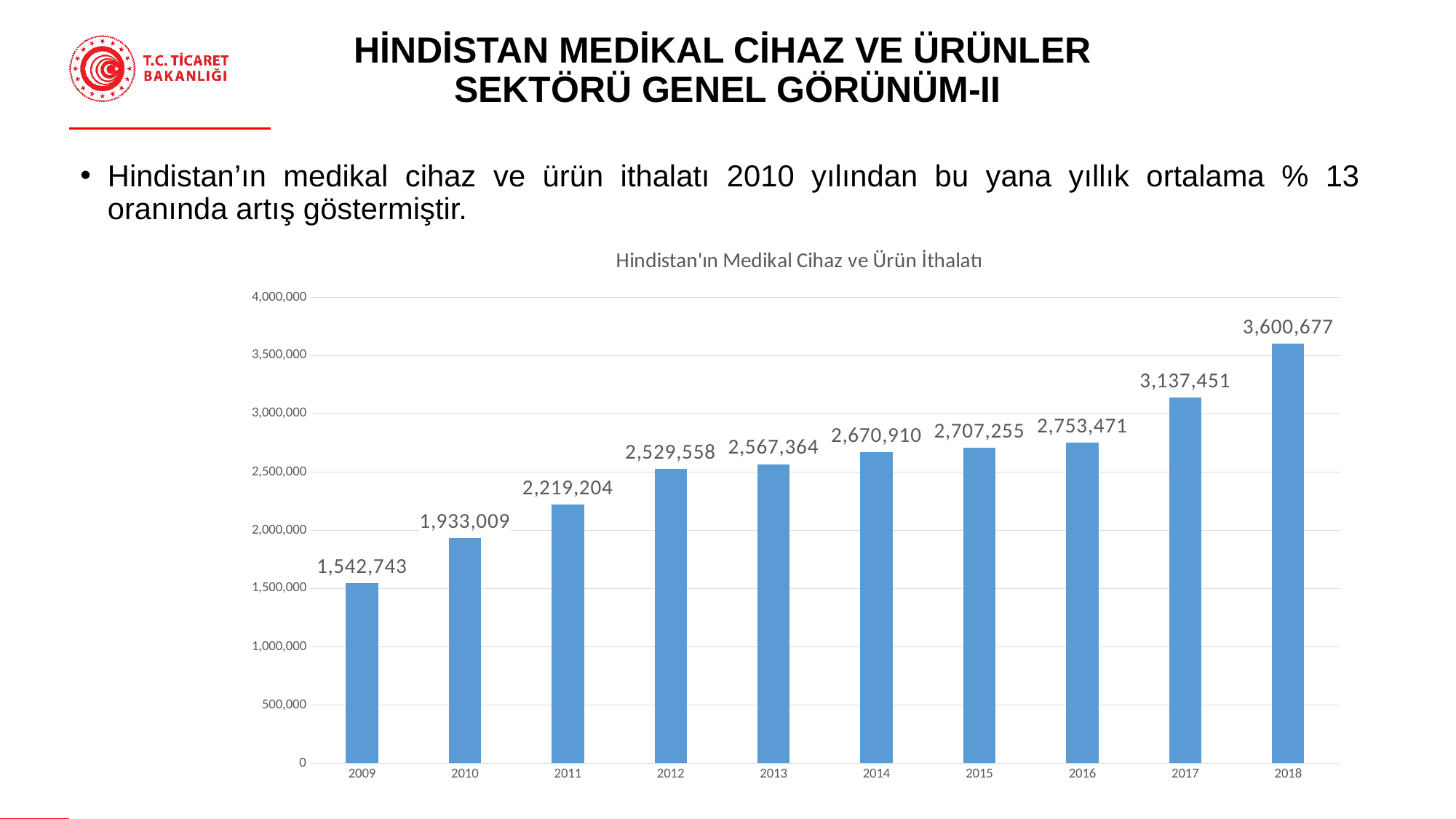
What is the value for 2018 in the chart? 3,600,677 Which year has the highest value in the chart? 2018 What is the value for 2014 in the chart? 2,670,910 What is the difference between the values for 2010 and 2009? 390,266 Do the values rise or fall from 2009 to 2018? rise What is the value for 2009 in the chart? 1,542,743 What kind of chart is shown on the slide? bar chart What is the difference between the values for 2018 and 2017? 463,226 Which year has the lowest value in the chart? 2009 Is the value for 2017 greater or less than 3,000,000? greater Which is larger, the value for 2012 or the value for 2013? 2013 How many years are shown on the x axis of the chart? 10